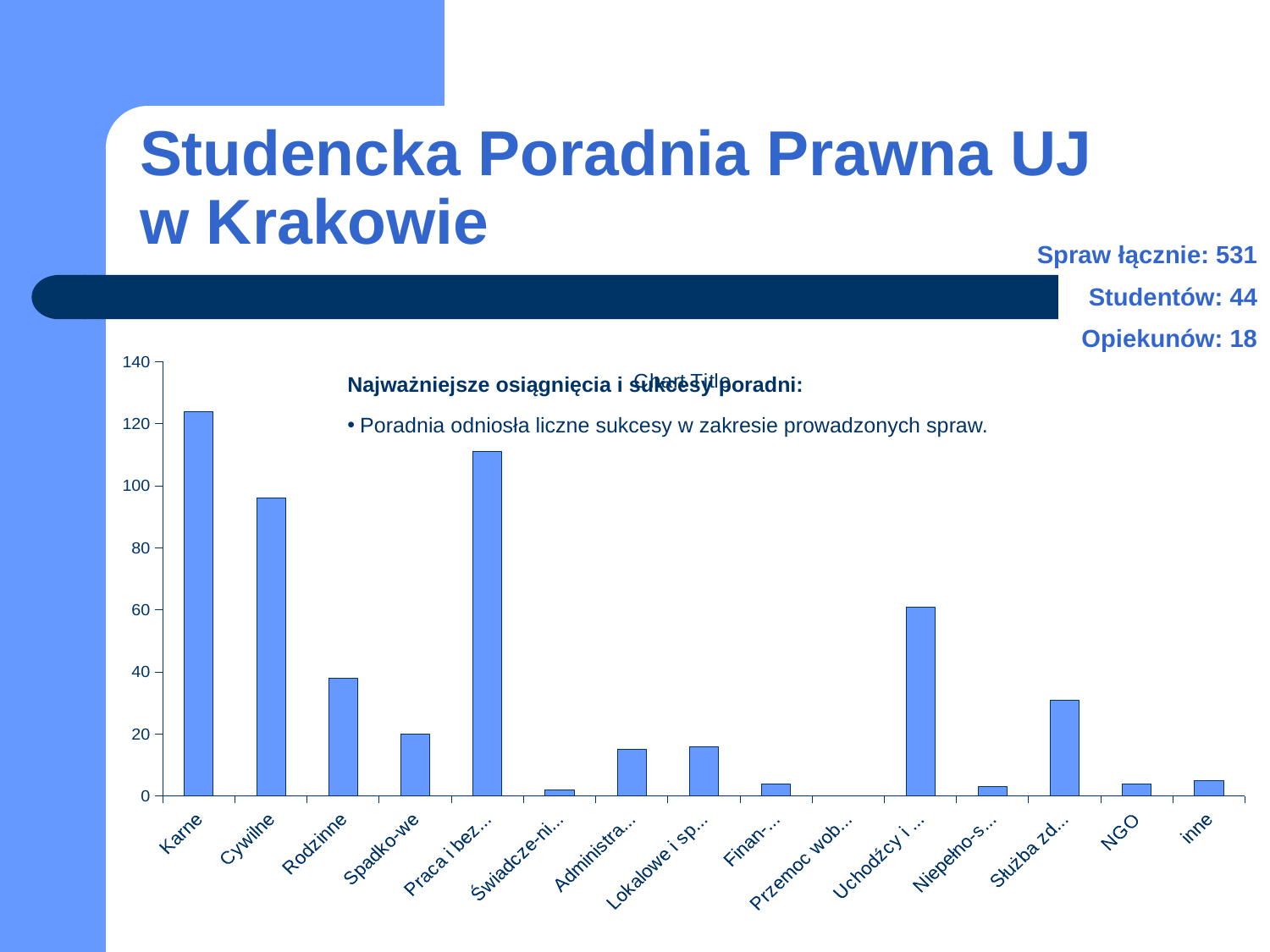
Is the value for NGO greater or less than 20? less Which is larger, the value for Karne or the value for Cywilne? Karne How many categories are shown on the x axis of the chart? 15 Is the value for Cywilne greater or less than 100? less Is the value for Karne greater or less than 120? greater What colour are the bars in the chart? blue Which is larger, the value for Rodzinne or the value for inne? Rodzinne Which category has the highest bar in the chart? Karne Which is larger, the value for Cywilne or the value for Praca i bez...? Praca i bez... What kind of chart is shown on the slide? bar chart